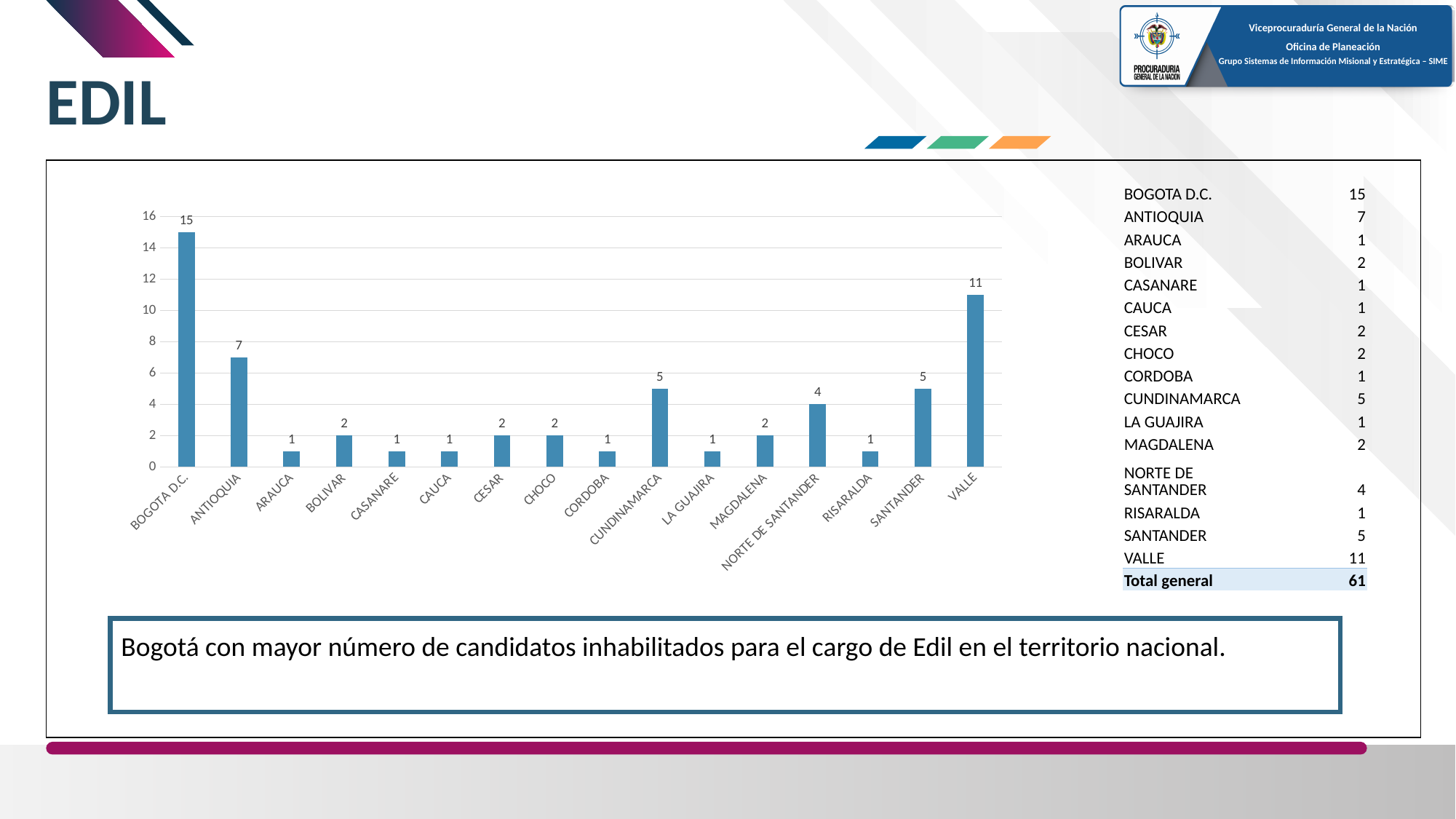
What is the value for CUNDINAMARCA? 5 What is the value for VALLE? 11 What is the value for NORTE DE SANTANDER? 4 Which is larger, the value for ANTIOQUIA or the value for VALLE? VALLE What is the difference between the values for ANTIOQUIA and SANTANDER? 2 What is the difference between the values for BOGOTA D.C. and VALLE? 4 What kind of chart is shown on the slide? bar chart What is the 'Total general' value shown in the table next to the chart? 61 Which category has the highest value? BOGOTA D.C. How many categories are shown on the x axis of the chart? 16 What is the value for BOGOTA D.C.? 15 Is the value for BOGOTA D.C. greater or less than 10? greater